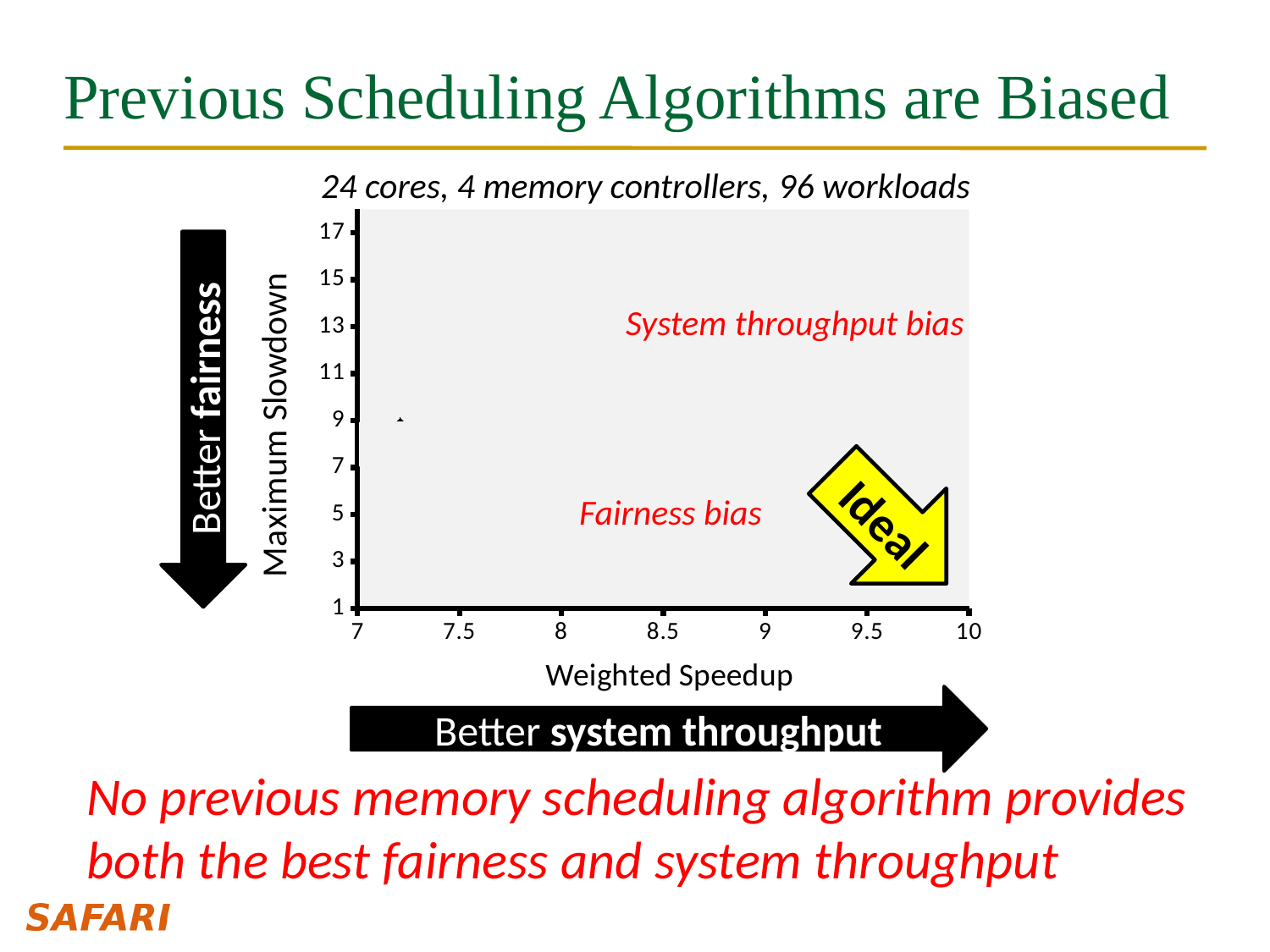
What is the title of the chart? 24 cores, 4 memory controllers, 96 workloads Is the Weighted Speedup of the plotted point greater or less than 8? less What kind of chart is shown on the slide? scatter chart How many data points are plotted on the chart? 1 Is the Weighted Speedup of the plotted point greater or less than 7.5? less What is the label of the y axis of the chart? Maximum Slowdown Is the Maximum Slowdown of the plotted point greater or less than 11? less